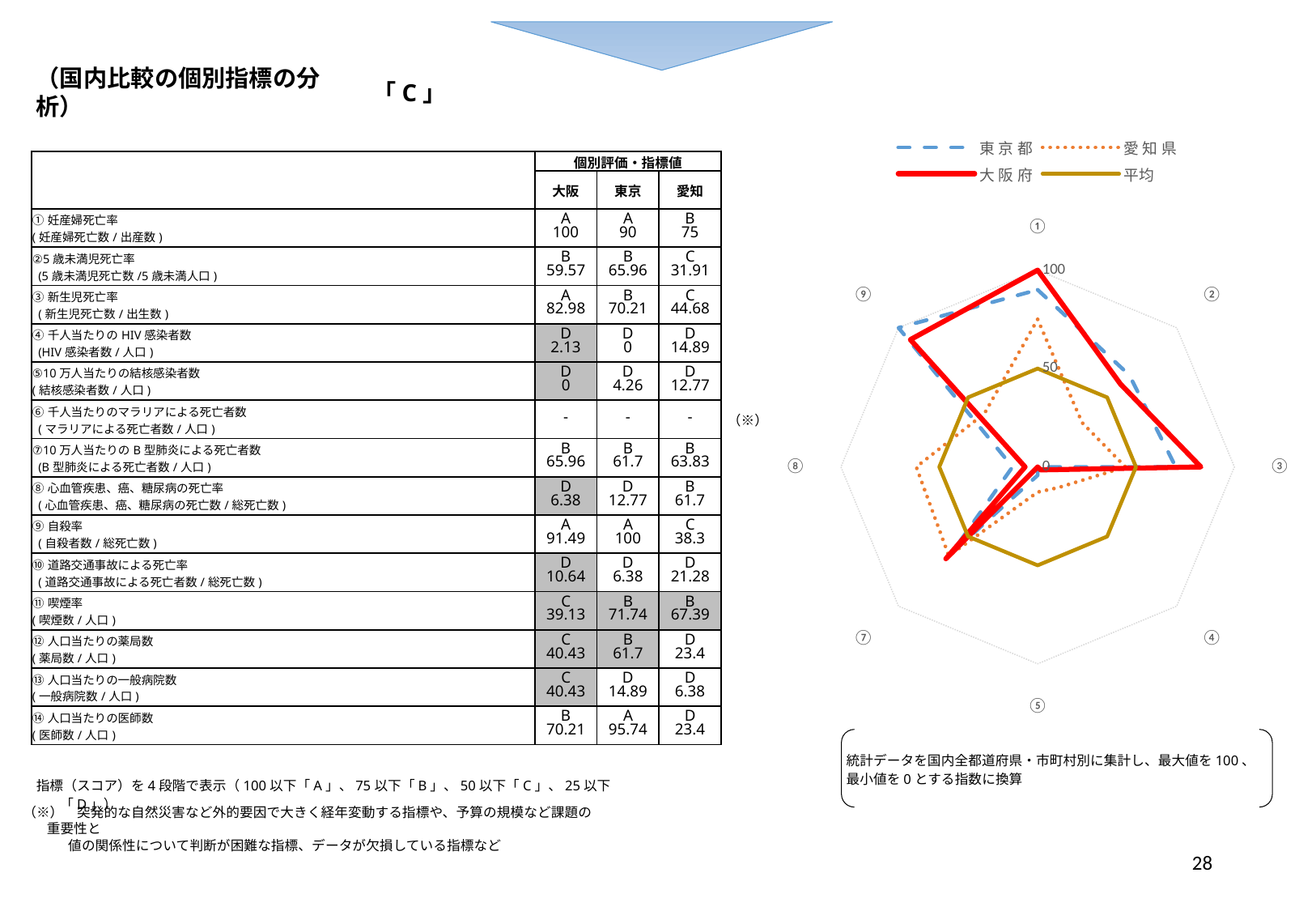
In the radar chart, is the value for 東京都 on axis ⑨ greater or less than 50? greater How many series does the legend of the radar chart list? 4 In the radar chart, is the value for 大阪府 on axis ⑤ greater or less than 50? less What are the four series named in the legend of the radar chart? 東京都, 愛知県, 大阪府, 平均 In the radar chart, which series is drawn as a solid red line? 大阪府 What is the highest tick label shown on the radial axis of the radar chart? 100 What kind of chart is shown on the right side of the slide? radar chart In the radar chart, which series has the highest value on axis ①? 大阪府 In the radar chart, is the value for 大阪府 on axis ① greater or less than 50? greater In the radar chart, on axis ⑧, which series has the larger value, 愛知県 or 大阪府? 愛知県 In the radar chart, on axis ③, which series has the larger value, 大阪府 or 愛知県? 大阪府